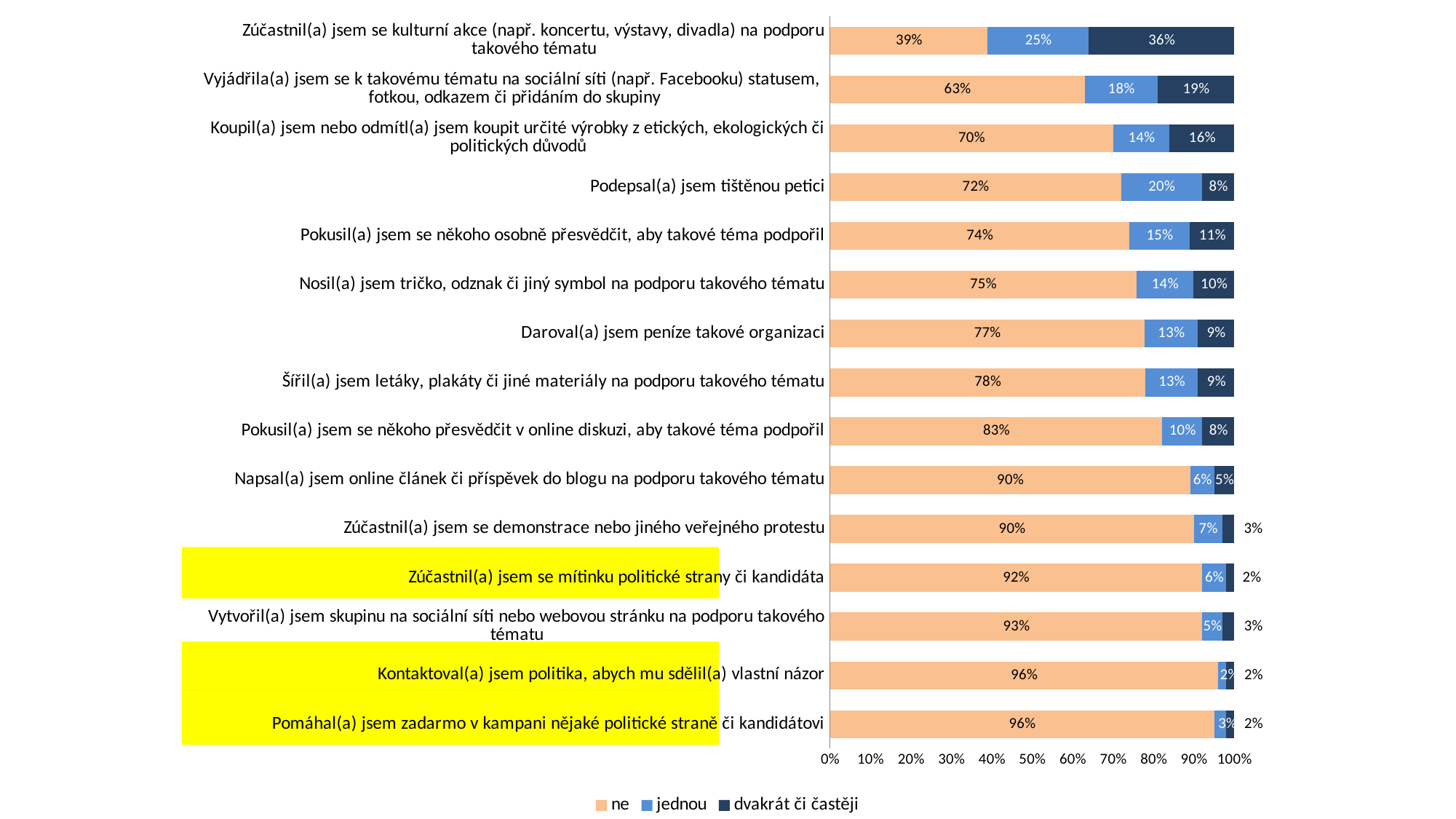
What is the value of 'jednou' for 'Daroval(a) jsem peníze takové organizaci'? 13% Which category has the lowest 'ne' value? Zúčastnil(a) jsem se kulturní akce (např. koncertu, výstavy, divadla) na podporu takového tématu Which is larger: the 'dvakrát či častěji' value for 'Koupil(a) jsem nebo odmítl(a) jsem koupit určité výrobky' or for 'Podepsal(a) jsem tištěnou petici'? Koupil(a) jsem nebo odmítl(a) jsem koupit určité výrobky Which legend entry is shown in the darkest colour? dvakrát či častěji What is the value of 'dvakrát či častěji' for 'Zúčastnil(a) jsem se kulturní akce (např. koncertu, výstavy, divadla) na podporu takového tématu'? 36% What is the total of the stacked bar for 'Pokusil(a) jsem se někoho přesvědčit v online diskuzi, aby takové téma podpořil'? 101% What is the difference between the 'ne' values for 'Vyjádřila(a) jsem se k takovému tématu na sociální síti' and 'Zúčastnil(a) jsem se kulturní akce'? 24% What kind of chart is shown on the slide? stacked bar chart How many series does the legend list? 3 Which category has the highest 'jednou' value? Zúčastnil(a) jsem se kulturní akce (např. koncertu, výstavy, divadla) na podporu takového tématu What is the value of 'ne' for 'Podepsal(a) jsem tištěnou petici'? 72% How many categories (statements) are plotted in the chart? 15